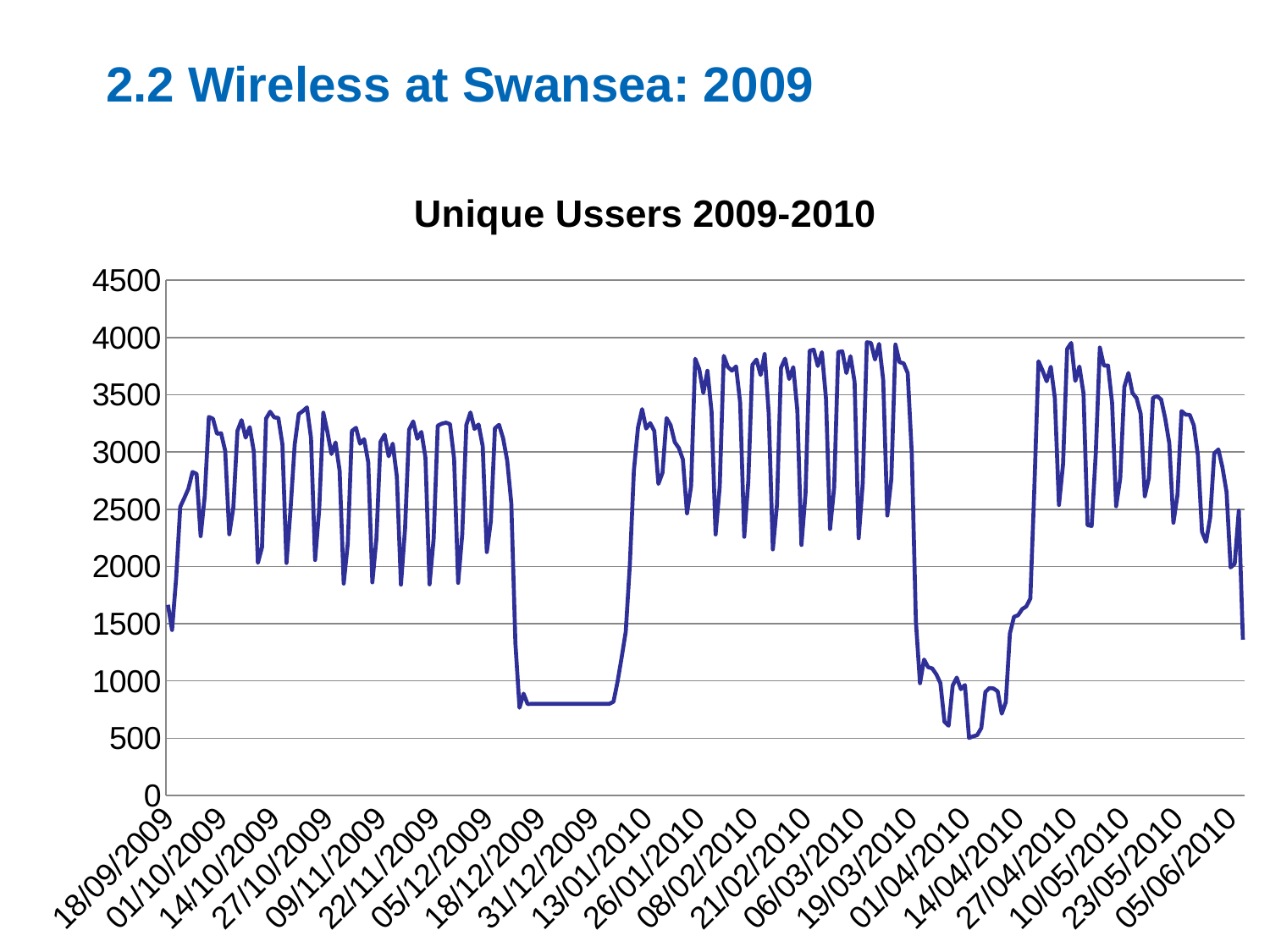
What is the title of the chart? Unique Ussers 2009-2010 What kind of chart is shown on the slide? line chart Which period has higher peak values: around 14/10/2009 or around 21/02/2010? around 21/02/2010 Around which x-axis date does the line reach its lowest point? 01/04/2010 Are the peak values around 21/02/2010 greater or less than 3500? greater How many lines (data series) are plotted on the chart? 1 Are the peak values around 14/10/2009 greater or less than 3500? less Is the value around 31/12/2009 greater or less than 1000? less What is the highest value shown on the y axis? 4500 How many date labels are shown along the x axis? 21